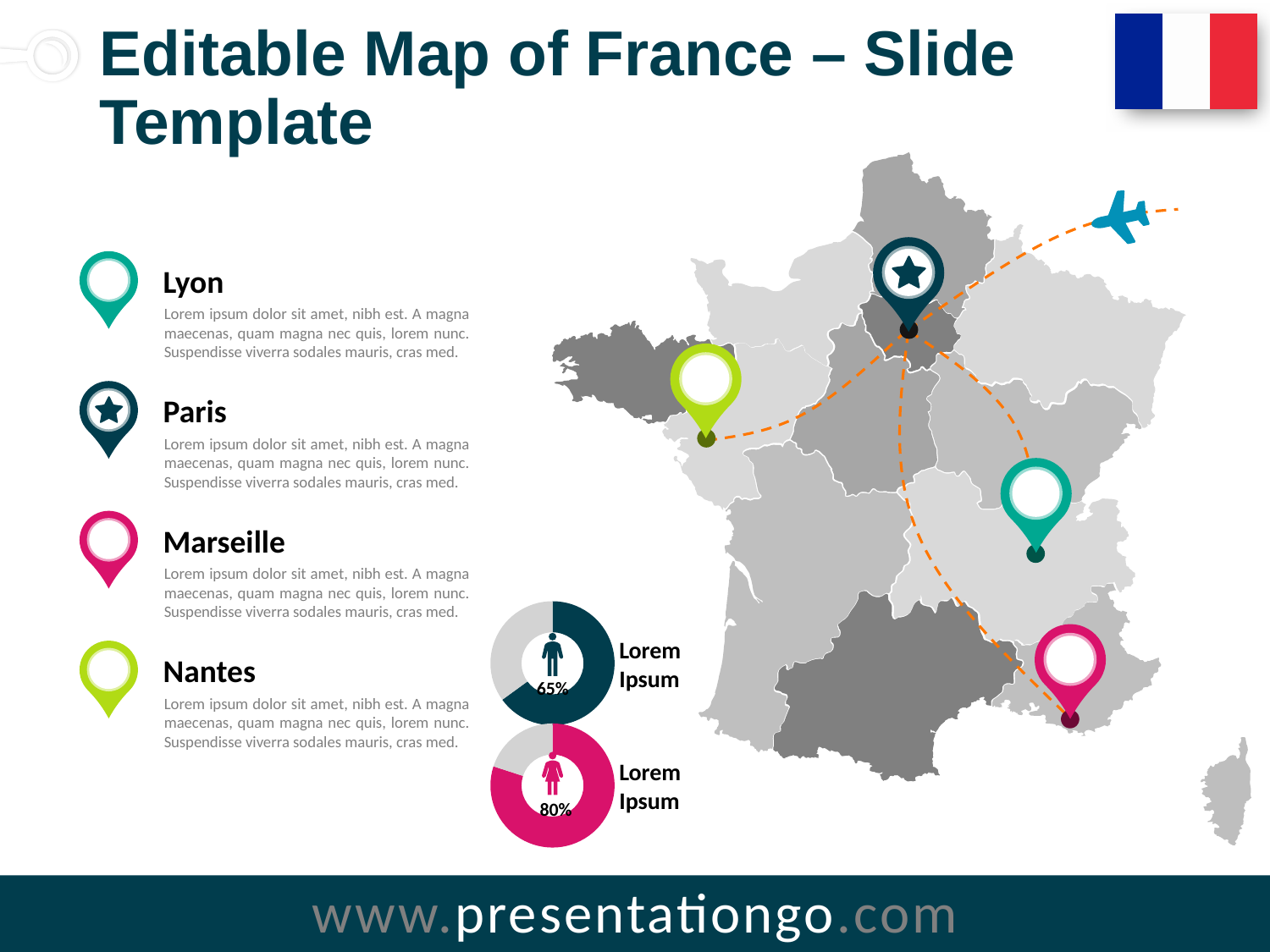
What colour is the filled portion of the lower donut chart showing 80%? Pink What is the difference between the percentage in the lower donut chart (80%) and the upper donut chart (65%)? 15% Is the value in the upper donut chart with the male icon greater or less than 50%? greater What label appears to the right of each donut chart? Lorem Ipsum How many donut charts are shown on the slide? 2 Which donut chart shows the larger percentage, the one with the male icon or the one with the female icon? The one with the female icon What kind of charts are the two small charts at the bottom left of the map? Donut charts What percentage is shown in the upper donut chart with the male figure icon? 65% Is the value in the lower donut chart with the female icon greater or less than 75%? greater What percentage is shown in the lower donut chart with the female figure icon? 80%